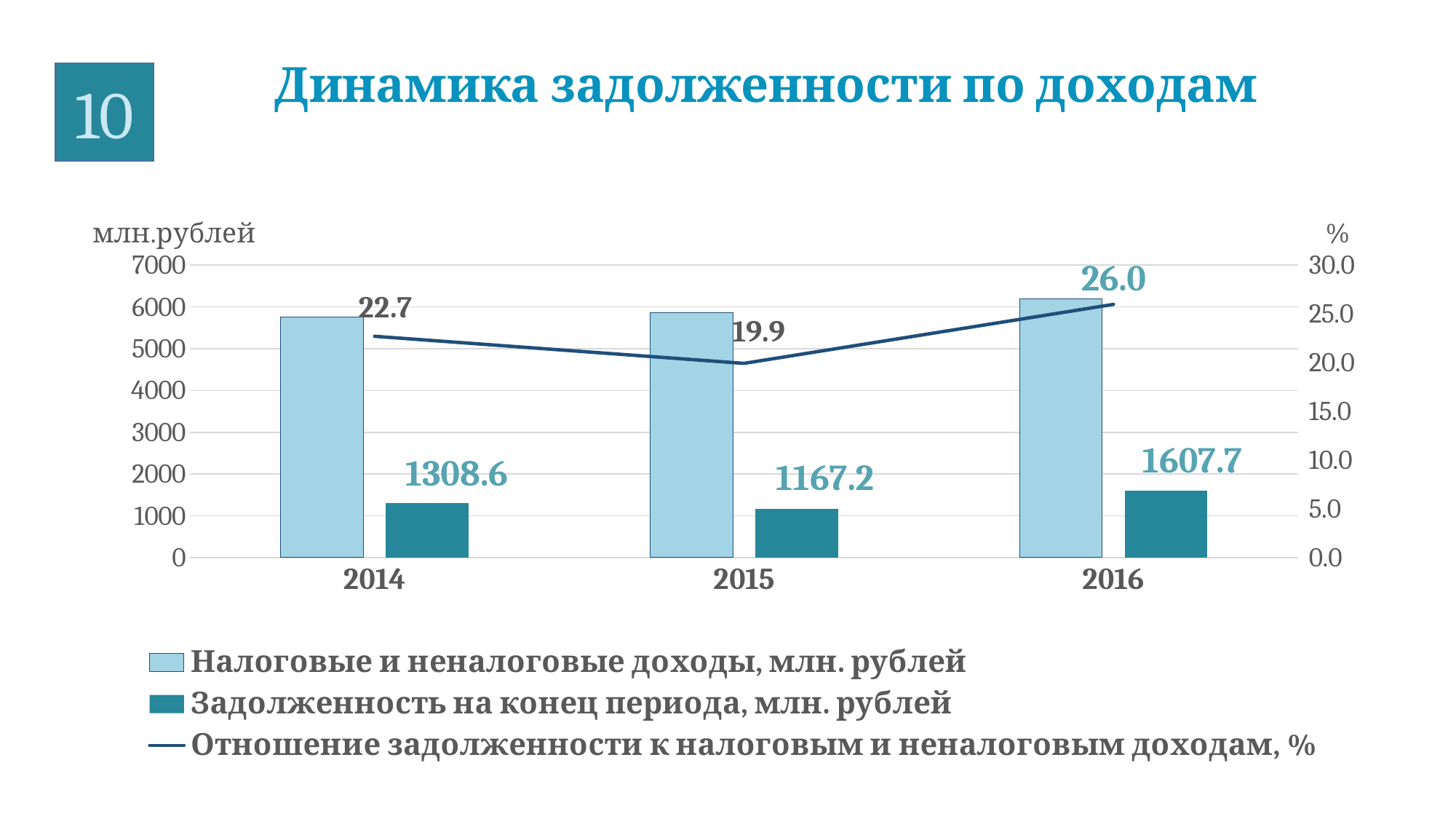
What is the difference between the 'Задолженность на конец периода, млн. рублей' values for 2016 and 2015? 440.5 What is the value of 'Задолженность на конец периода, млн. рублей' for 2016? 1607.7 What is the title of the chart? Динамика задолженности по доходам Is the value of 'Налоговые и неналоговые доходы, млн. рублей' for 2016 greater or less than 7000? less In which year is 'Отношение задолженности к налоговым и неналоговым доходам, %' the lowest? 2015 Is the value of 'Налоговые и неналоговые доходы, млн. рублей' for 2014 greater or less than 5000? greater What is the value of 'Задолженность на конец периода, млн. рублей' for 2015? 1167.2 What is the value of 'Отношение задолженности к налоговым и неналоговым доходам, %' for 2014? 22.7 Which is larger: the 'Отношение задолженности к налоговым и неналоговым доходам, %' value for 2014 or for 2016? 2016 In which year is 'Задолженность на конец периода, млн. рублей' the highest? 2016 How many series does the legend list? 3 How many years are shown on the x axis of the chart? 3